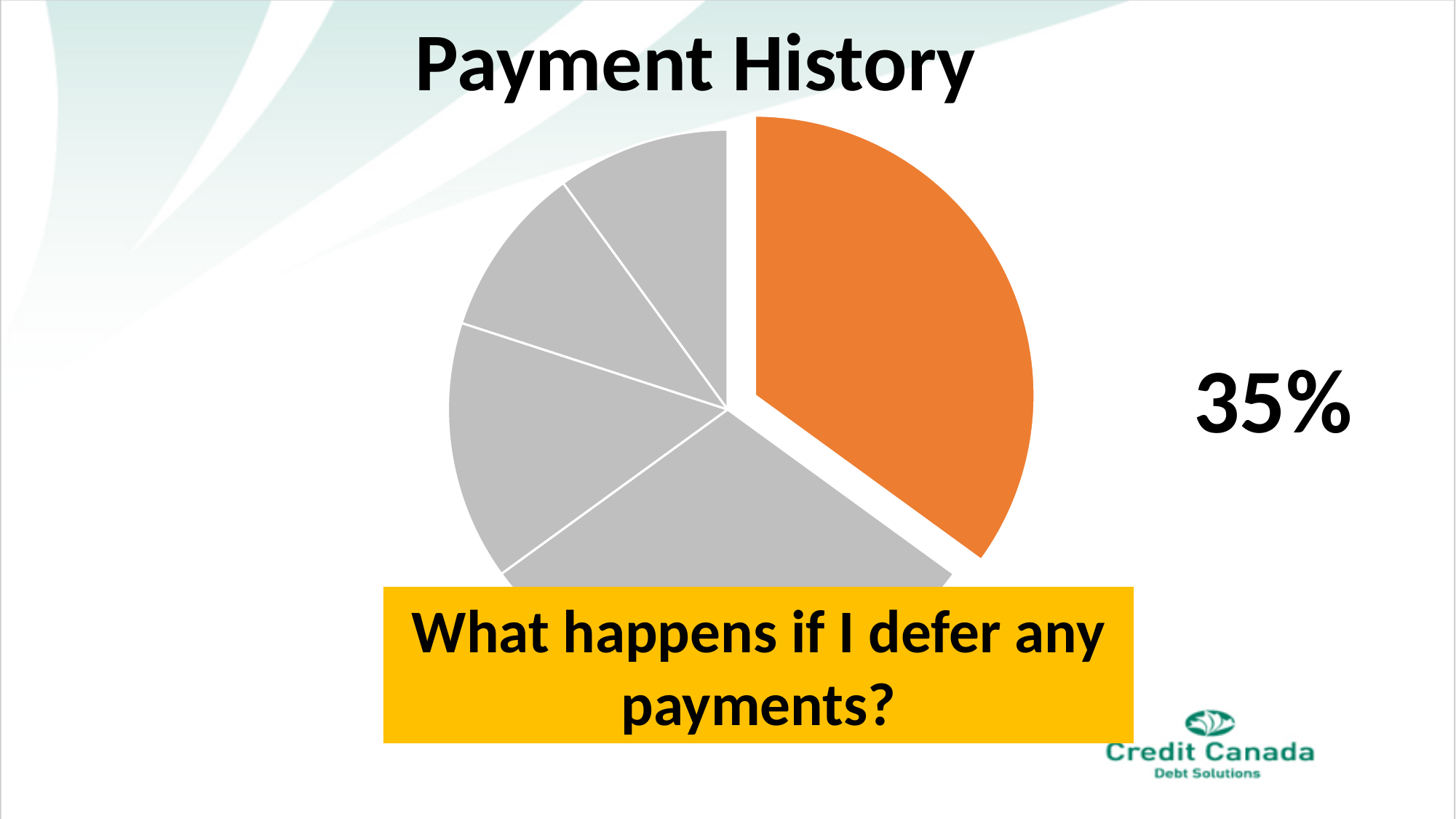
Is the share of the orange slice greater or less than 50%? less Is the share of the orange slice greater or less than 25%? greater What kind of chart is shown on the slide? pie chart What share of the pie does the exploded orange slice represent? 35% What percentage is shown for the highlighted (orange) slice of the pie chart? 35% What colour is the highlighted, exploded slice of the pie chart? orange What is the title of the chart on the slide? Payment History Which is larger: the orange slice or the small grey slice at the top of the pie? the orange slice